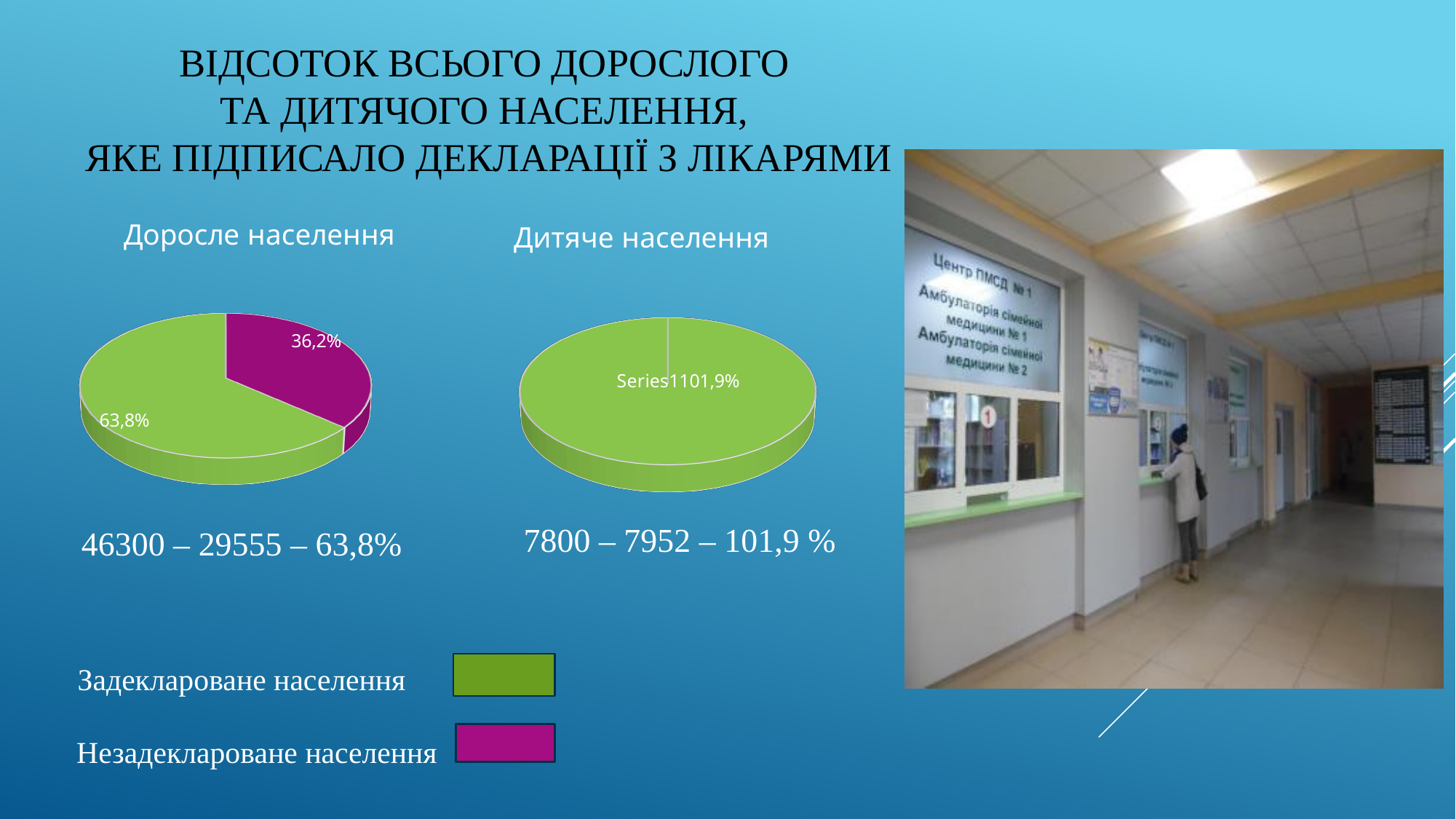
What is the title of the pie chart on the left? Доросле населення What kind of chart is used for "Доросле населення"? pie chart How many pie charts are on the slide? 2 How many visible slices does the "Дитяче населення" pie chart have? 1 In the "Доросле населення" pie chart, which slice is larger: the green one or the magenta one? the green one In the "Доросле населення" pie chart, what share is shown for the green slice (Задекларованe населення)? 63,8% How many slices does the "Доросле населення" pie chart have? 2 According to the legend, which colour represents "Незадекларованe населення"? magenta In the "Доросле населення" pie chart, what share is shown for the magenta slice (Незадекларованe населення)? 36,2% In the "Доросле населення" pie chart, what is the difference between the two slice percentages? 27,6% What percentage is printed on the "Дитяче населення" pie chart? 101,9% Is the green slice in the "Доросле населення" pie chart greater or less than 50%? greater